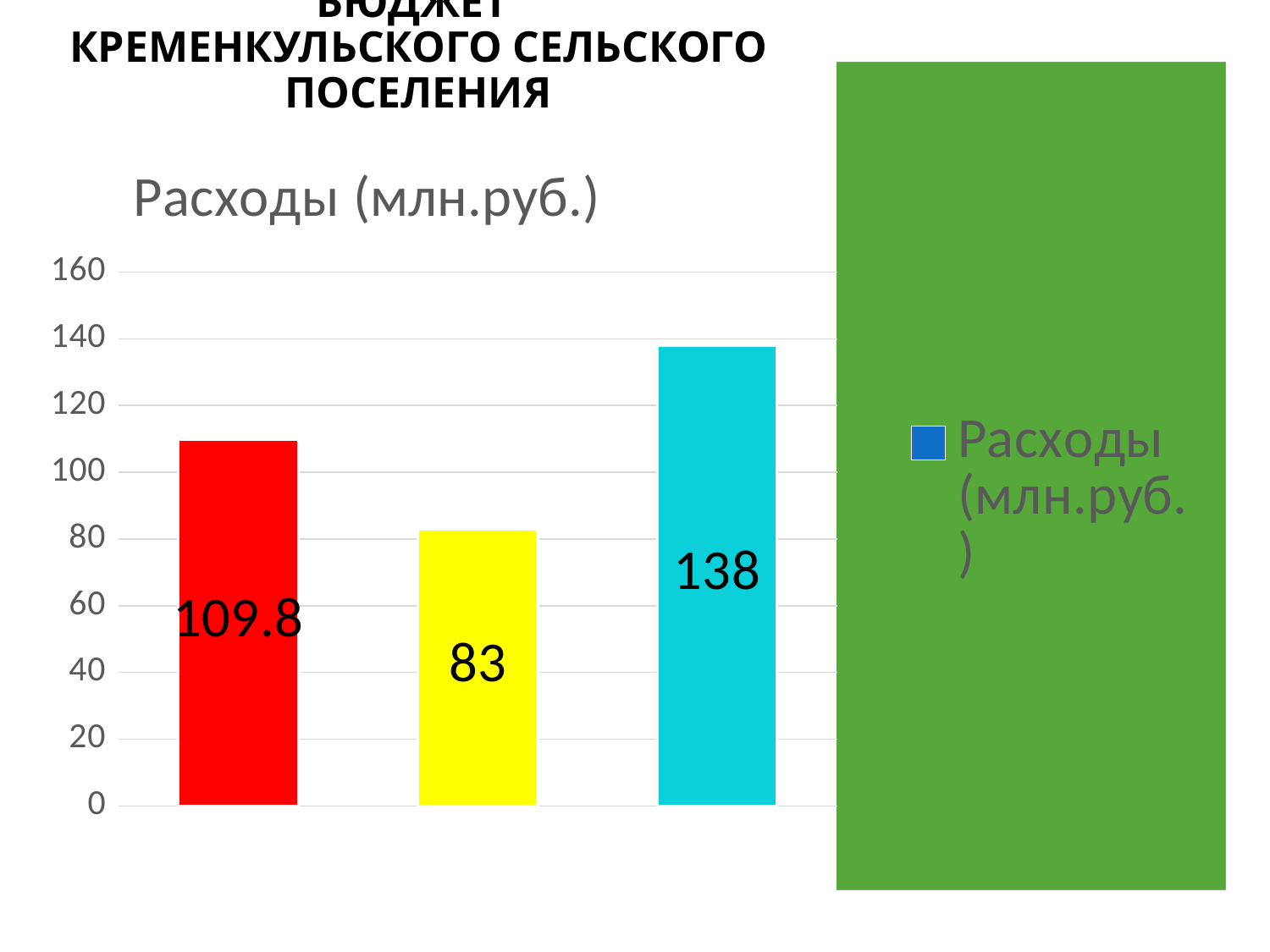
What is the value shown on the red bar? 109.8 What is the difference between the value of the cyan bar and the value of the yellow bar? 55 Is the value of the red bar greater or less than 100? greater Which bar has the highest value? The cyan bar (138) How many bars are plotted in the chart? 3 How many series does the legend list? 1 What is the difference between the value of the red bar and the value of the yellow bar? 26.8 Which is larger, the value of the red bar or the value of the cyan bar? The cyan bar Which bar has the lowest value? The yellow bar (83) What is the value shown on the cyan (light blue) bar? 138 What is the value shown on the yellow bar? 83 What type of chart is shown on the slide? Bar chart